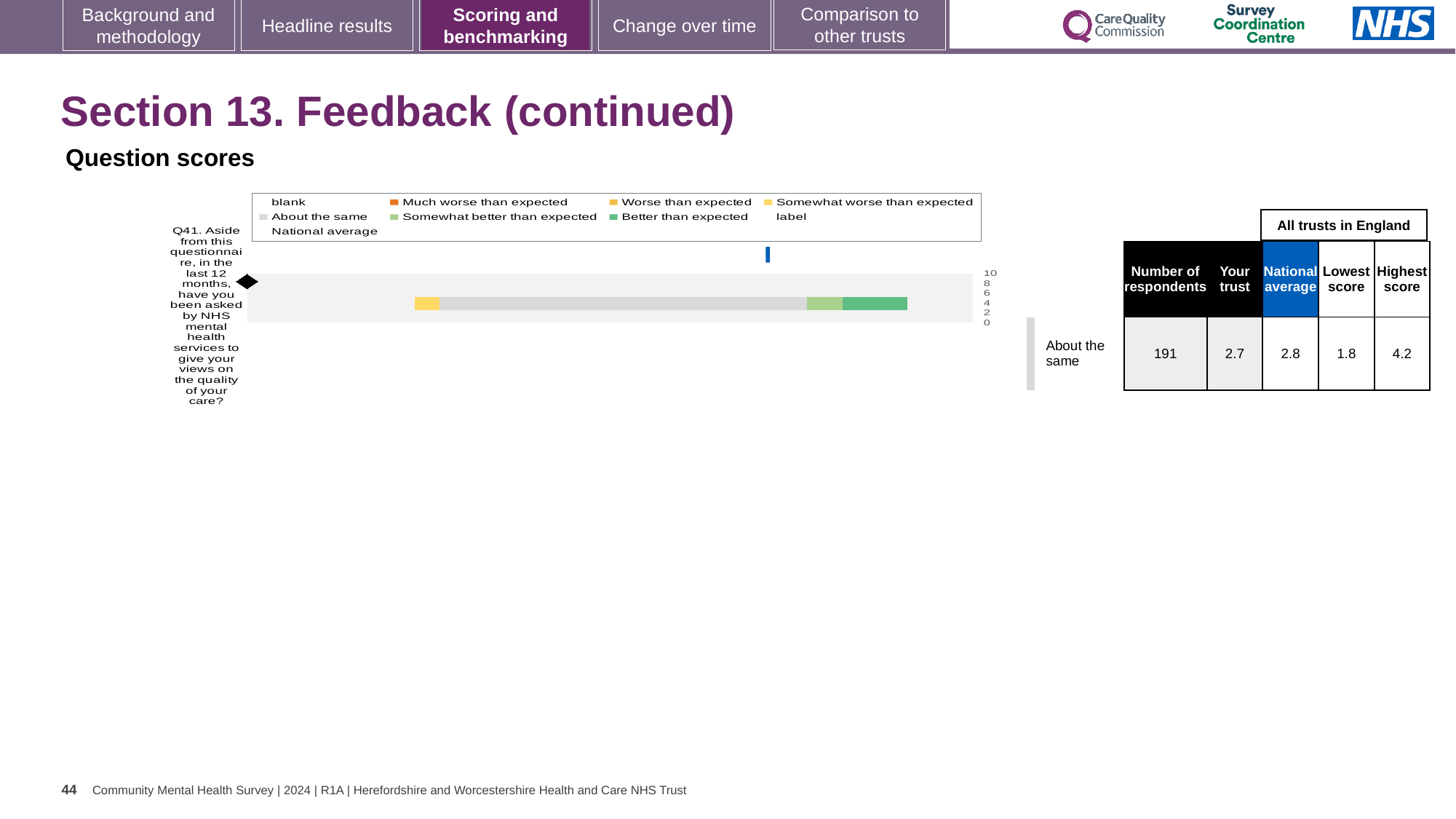
According to the table beside the chart, how many respondents answered Q41? 191 How many question categories are plotted in the chart? 1 Which question is plotted in the chart? Q41. Aside from this questionnaire, in the last 12 months, have you been asked by NHS mental health services to give your views on the quality of your care? According to the table beside the chart, what is the 'Your trust' score for Q41? 2.7 According to the table beside the chart, what is the national average score for Q41? 2.8 According to the table beside the chart, what is the highest score among all trusts in England for Q41? 4.2 Which legend entry is shown in dark green in the chart? Better than expected According to the table beside the chart, what is the lowest score among all trusts in England for Q41? 1.8 What kind of chart is shown on the slide? bar chart How many entries does the chart's legend list? 9 Which is larger for Q41, the 'Your trust' score or the national average? National average What is the difference between the highest score and the lowest score for Q41 in the table beside the chart? 2.4